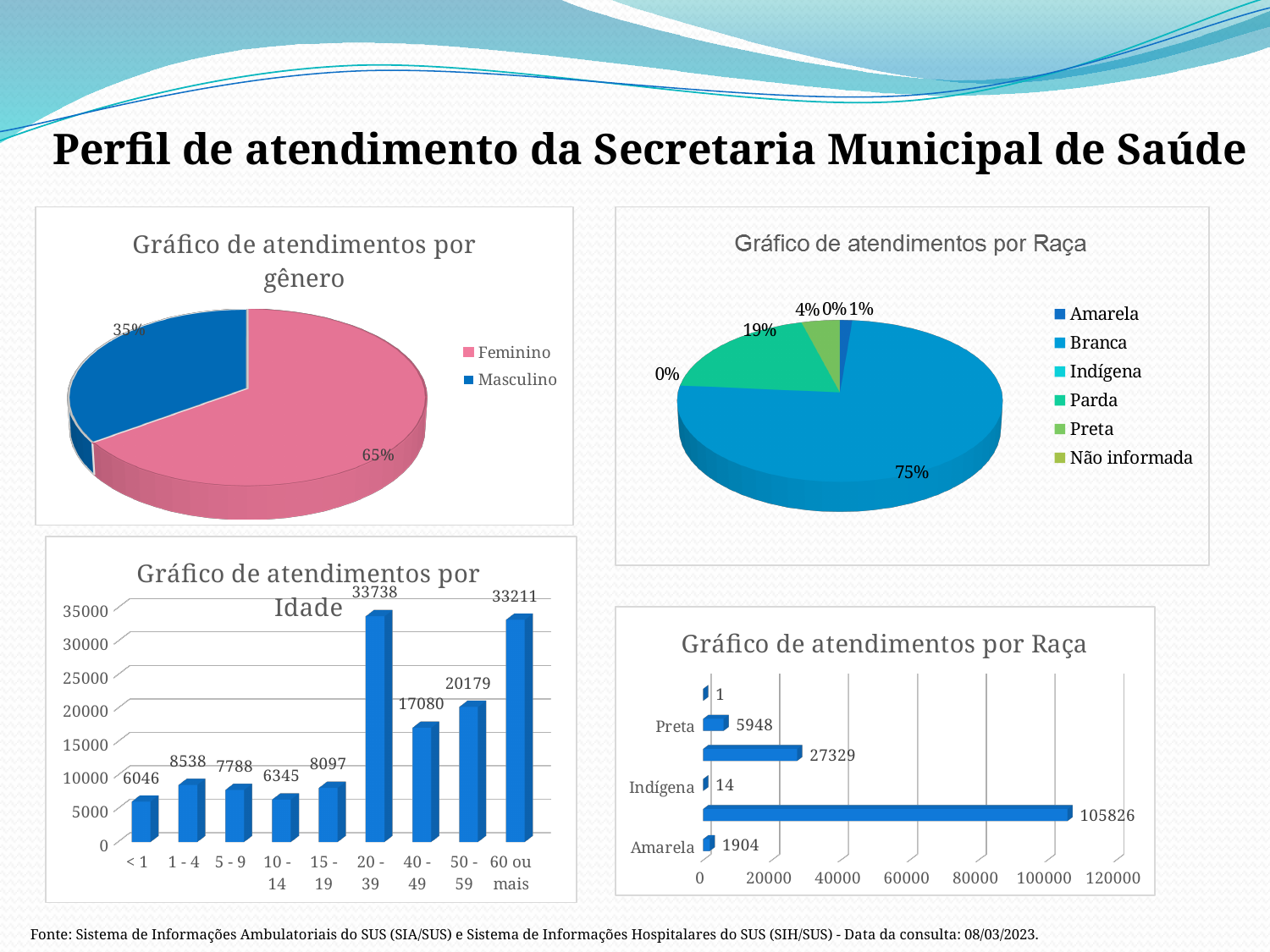
In the 'Gráfico de atendimentos por Idade' chart (bottom left), what is the difference between the 50 - 59 and 40 - 49 values? 3099 How many entries does the legend of the 'Gráfico de atendimentos por Raça' pie chart (top right) list? 6 In the 'Gráfico de atendimentos por Idade' chart (bottom left), what is the value for the 20 - 39 age group? 33738 In the 'Gráfico de atendimentos por Raça' bar chart (bottom right), what is the value for Preta? 5948 In the 'Gráfico de atendimentos por gênero' pie chart (top left), what share is Feminino? 65% In the 'Gráfico de atendimentos por Raça' bar chart (bottom right), which is larger, the value for Amarela or the value for Indígena? Amarela In the 'Gráfico de atendimentos por Idade' chart (bottom left), which age group has the lowest value? < 1 In the 'Gráfico de atendimentos por Raça' pie chart (top right), what share is Parda? 19% In the 'Gráfico de atendimentos por Idade' chart (bottom left), how many age groups are shown on the x axis? 9 In the 'Gráfico de atendimentos por gênero' pie chart (top left), what share is Masculino? 35% What kind of chart is the 'Gráfico de atendimentos por Raça' chart at the bottom right of the slide? Bar chart